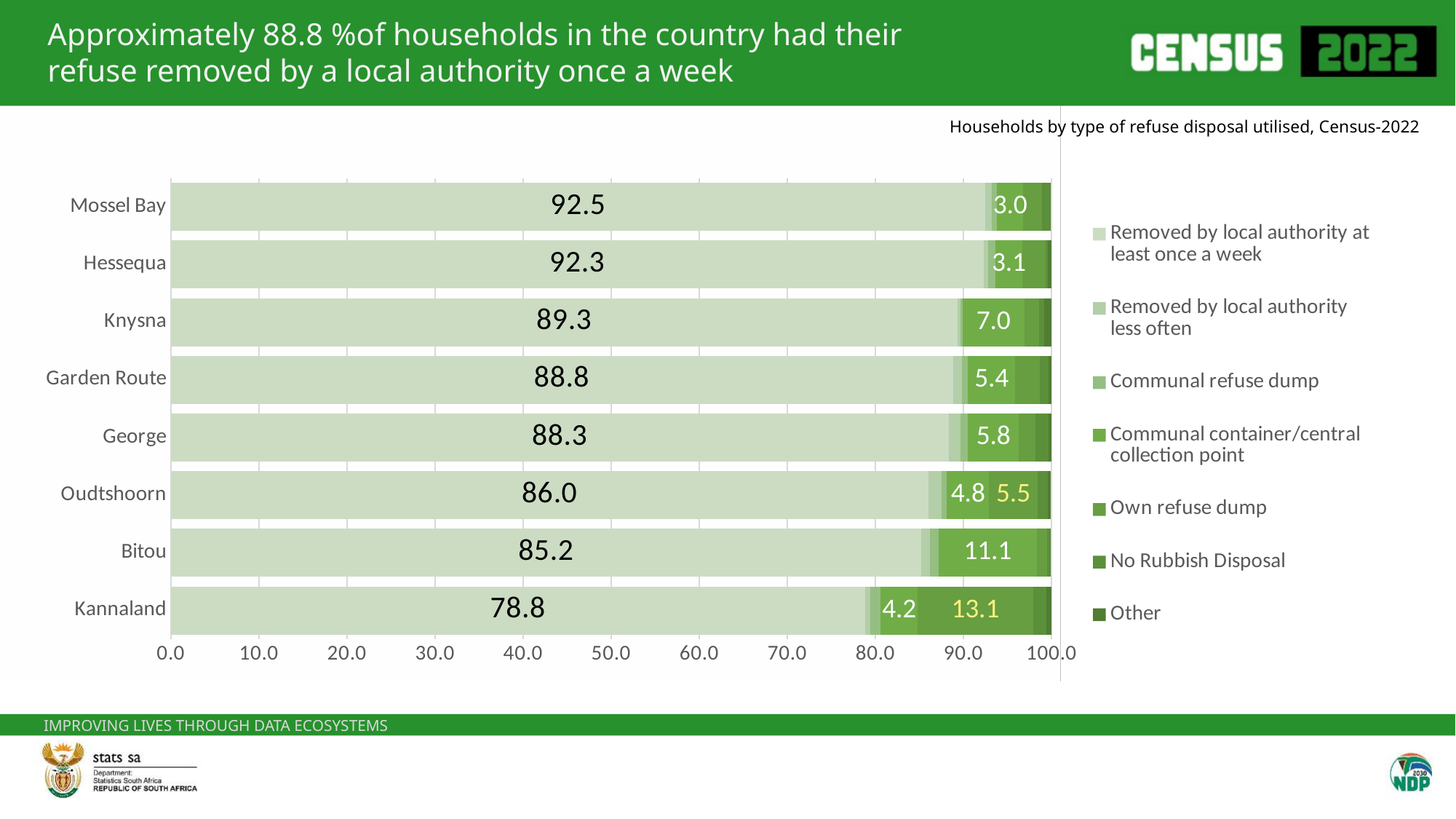
Which municipality has the lowest share of households with refuse removed by local authority at least once a week? Kannaland What kind of chart is shown on the slide? Stacked bar chart What is the value for Kannaland for refuse removed by local authority at least once a week? 78.8 What is the value for Garden Route for refuse removed by local authority at least once a week? 88.8 Is the value for Bitou for refuse removed by local authority at least once a week greater or less than 80.0? greater Which has a larger value for refuse removed by local authority at least once a week, Knysna or George? Knysna What percentage of households in Mossel Bay had refuse removed by local authority at least once a week? 92.5 What is the difference between Mossel Bay and Kannaland for refuse removed by local authority at least once a week? 13.7 Which municipality has the highest share of households with refuse removed by local authority at least once a week? Mossel Bay How many series does the legend list? 7 How many municipalities are shown on the chart? 8 What is the difference between Hessequa and Garden Route for refuse removed by local authority at least once a week? 3.5